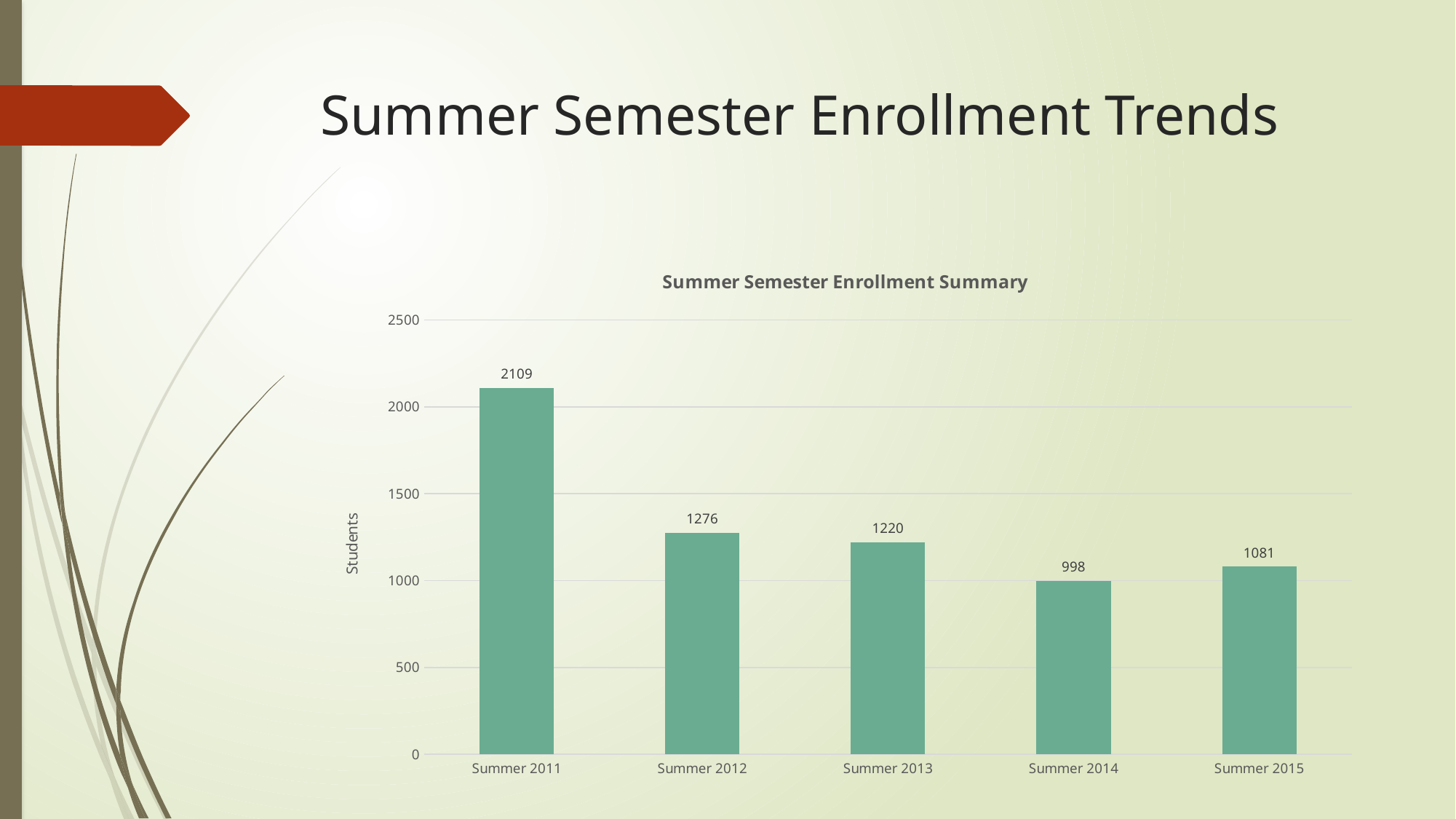
What is the difference in enrollment between Summer 2011 and Summer 2012? 833 What is the enrollment value for Summer 2011? 2109 What is the difference in enrollment between Summer 2015 and Summer 2014? 83 Which semester has the highest enrollment? Summer 2011 How many semesters are shown on the chart? 5 Is the value for Summer 2014 greater or less than 1000? less What kind of chart is shown on the slide? bar chart Which has a larger enrollment, Summer 2012 or Summer 2013? Summer 2012 What is the enrollment value for Summer 2015? 1081 Which semester has the lowest enrollment? Summer 2014 What is the enrollment value for Summer 2014? 998 What is the title of the chart? Summer Semester Enrollment Summary